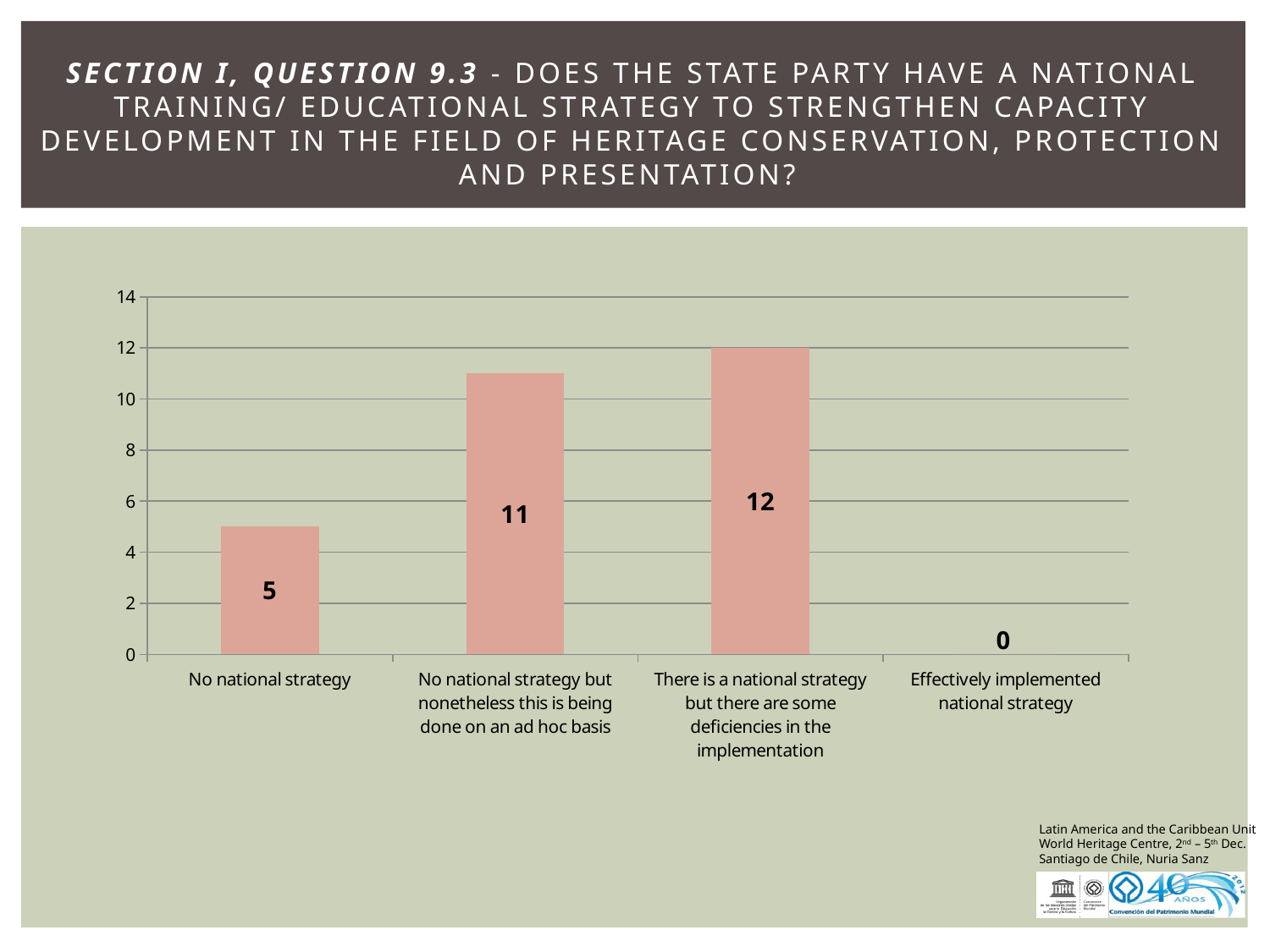
What is the total of all four values shown in the chart? 28 Which category has the highest value? There is a national strategy but there are some deficiencies in the implementation Which is larger: the value for "No national strategy" or the value for "No national strategy but nonetheless this is being done on an ad hoc basis"? No national strategy but nonetheless this is being done on an ad hoc basis Is the value for "No national strategy" greater or less than 8? less How many categories are shown on the x axis? 4 What is the value for "Effectively implemented national strategy"? 0 What kind of chart is shown on the slide? Bar chart Which category has the lowest value? Effectively implemented national strategy What is the difference between the values for "There is a national strategy but there are some deficiencies in the implementation" and "No national strategy"? 7 What is the value for "No national strategy"? 5 What is the value for "No national strategy but nonetheless this is being done on an ad hoc basis"? 11 What is the value for "There is a national strategy but there are some deficiencies in the implementation"? 12